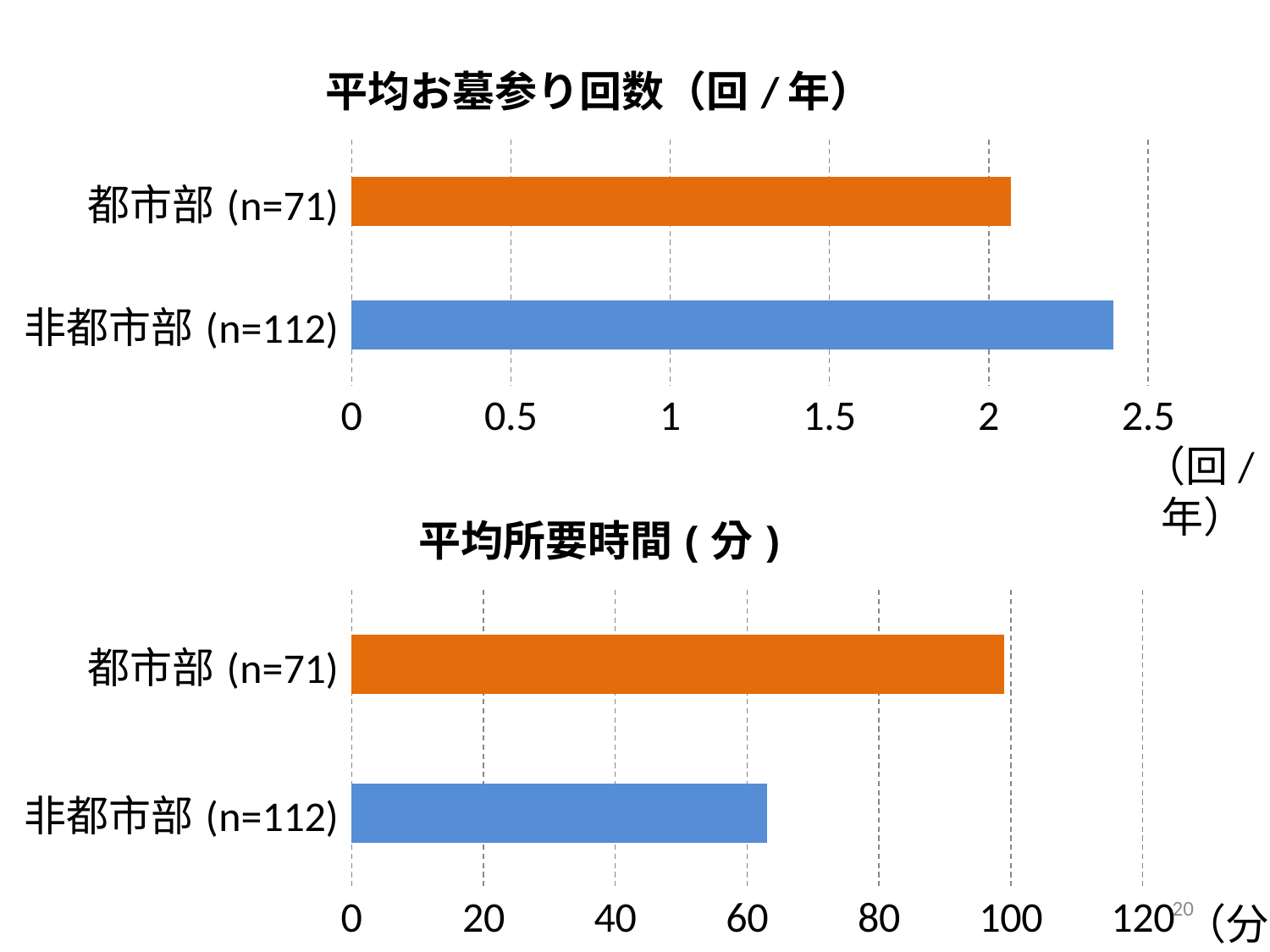
What kind of chart is the top chart titled 平均お墓参り回数（回／年）? bar chart In the top chart (平均お墓参り回数), which category has the highest value? 非都市部 (n=112) In the top chart (平均お墓参り回数), how many categories are plotted? 2 In the top chart (平均お墓参り回数), is the value for 非都市部 (n=112) greater or less than 2.5? less In the bottom chart (平均所要時間), is the value for 都市部 (n=71) larger or smaller than the value for 非都市部 (n=112)? larger In the bottom chart (平均所要時間), how many categories are plotted? 2 In the bottom chart (平均所要時間), is the value for 都市部 (n=71) greater or less than 80? greater In the bottom chart (平均所要時間), is the value for 非都市部 (n=112) greater or less than 80? less In the bottom chart (平均所要時間), which category has the lowest value? 非都市部 (n=112) In the top chart (平均お墓参り回数), what colour is the bar for 都市部 (n=71)? orange What is the title of the bottom chart? 平均所要時間 ( 分 )